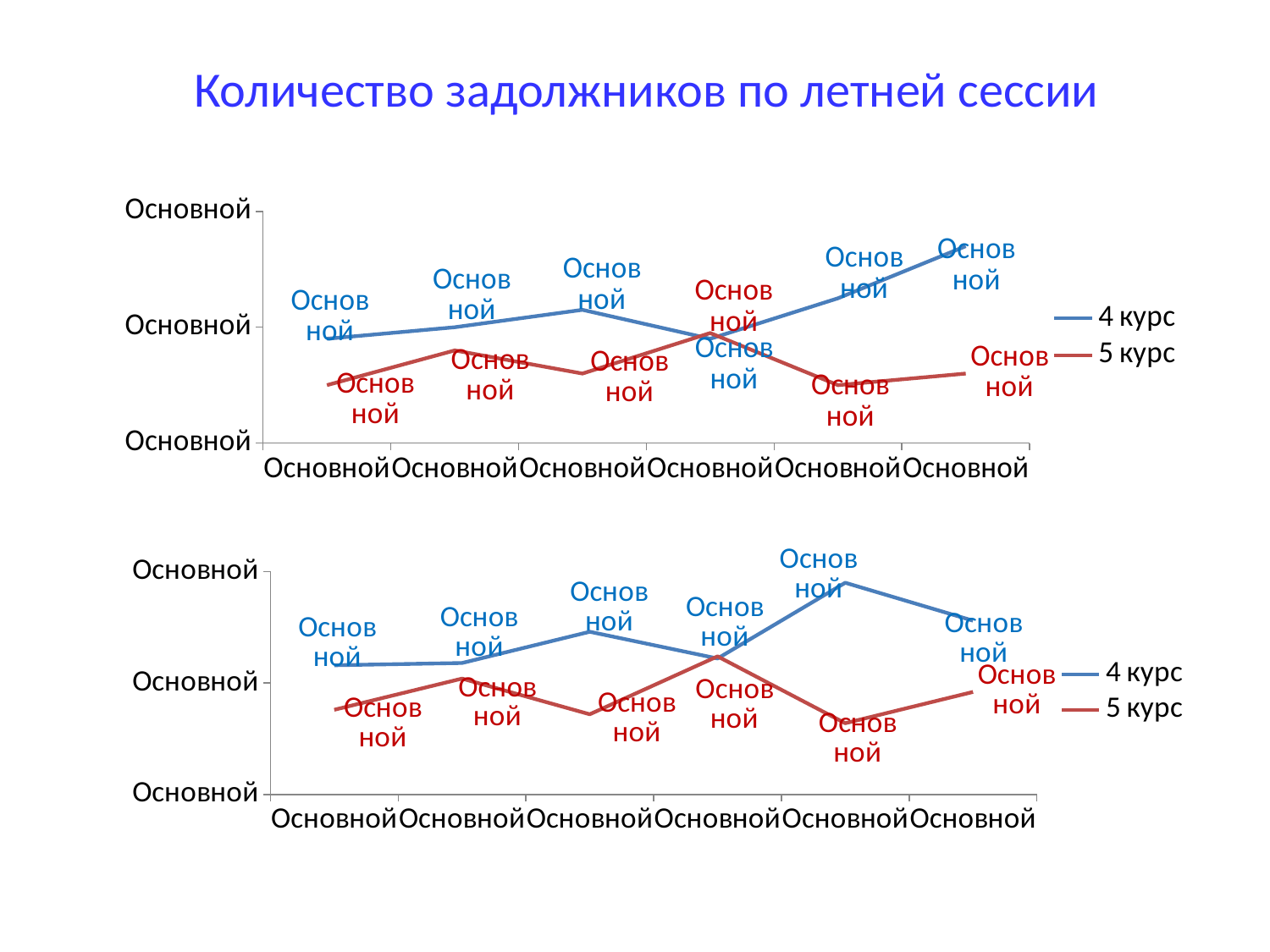
How many data points does each line in the top chart have? 6 What kind of chart is the top chart on the slide? line chart In the top chart, which series is higher at the leftmost point, 4 курс or 5 курс? 4 курс How many series does the legend of the top chart list? 2 In the bottom chart, which series is higher at the rightmost point, 4 курс or 5 курс? 4 курс In the top chart, which series is higher at the rightmost point, 4 курс or 5 курс? 4 курс In the top chart, does the 4 курс line end higher or lower than it starts? higher How many series does the legend of the bottom chart list? 2 What is the title of the slide above the charts? Количество задолжников по летней сессии What kind of chart is the bottom chart on the slide? line chart What are the two legend entries shown for the bottom chart? 4 курс and 5 курс How many categories are plotted along the x axis of the bottom chart? 6